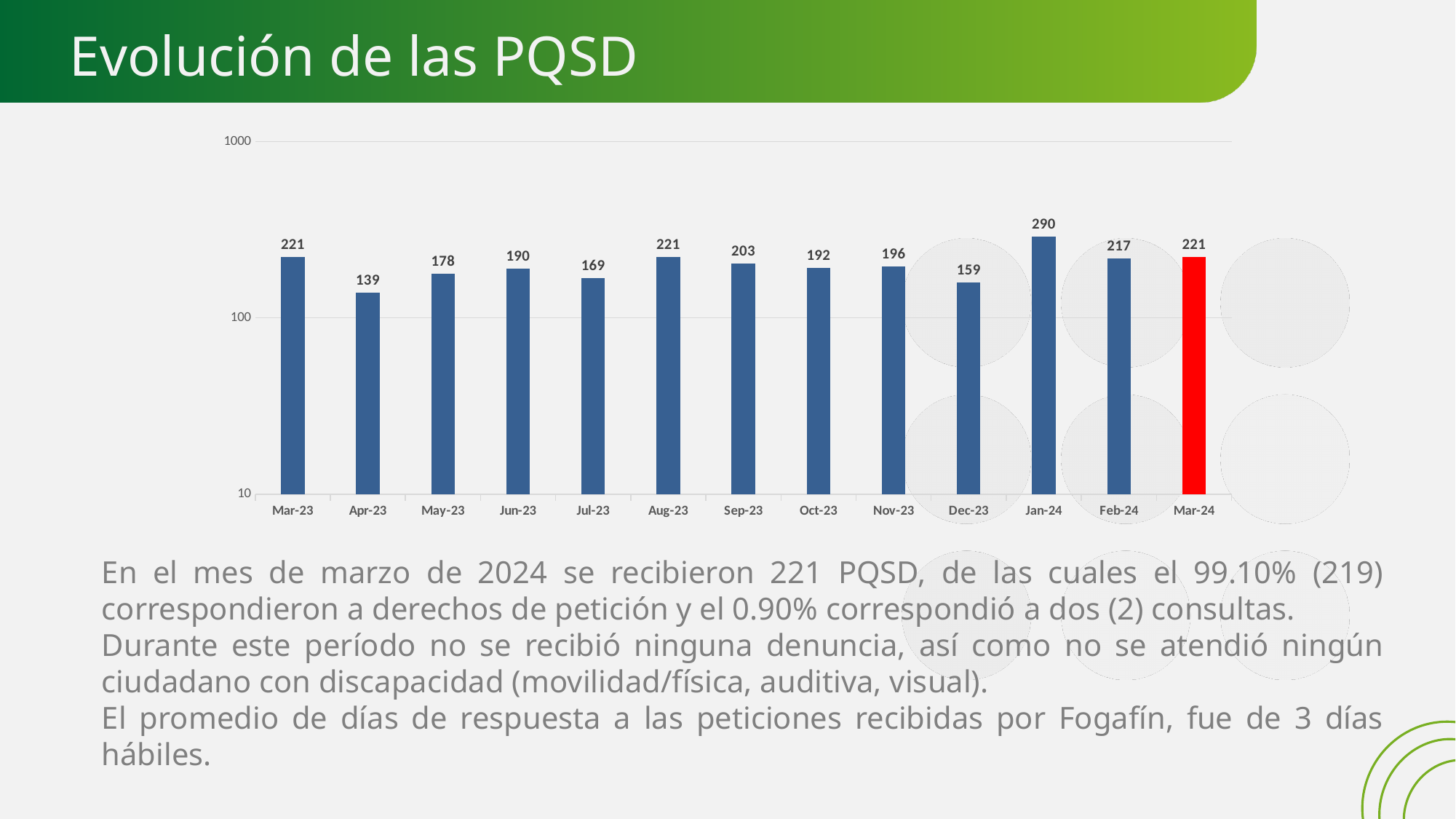
What is the value for Apr-23? 139 How many months are shown on the x axis? 13 What is the value for Dec-23? 159 What is the difference between the values for Jan-24 and Feb-24? 73 What is the value for Jan-24? 290 Which bar is coloured red? Mar-24 Which month has the highest value? Jan-24 Which is larger, the value for Sep-23 or the value for Oct-23? Sep-23 What kind of chart is shown on the slide? bar chart Which month has the lowest value? Apr-23 Is the value for Jul-23 greater or less than 100? greater What is the difference between the values for Mar-24 and Dec-23? 62